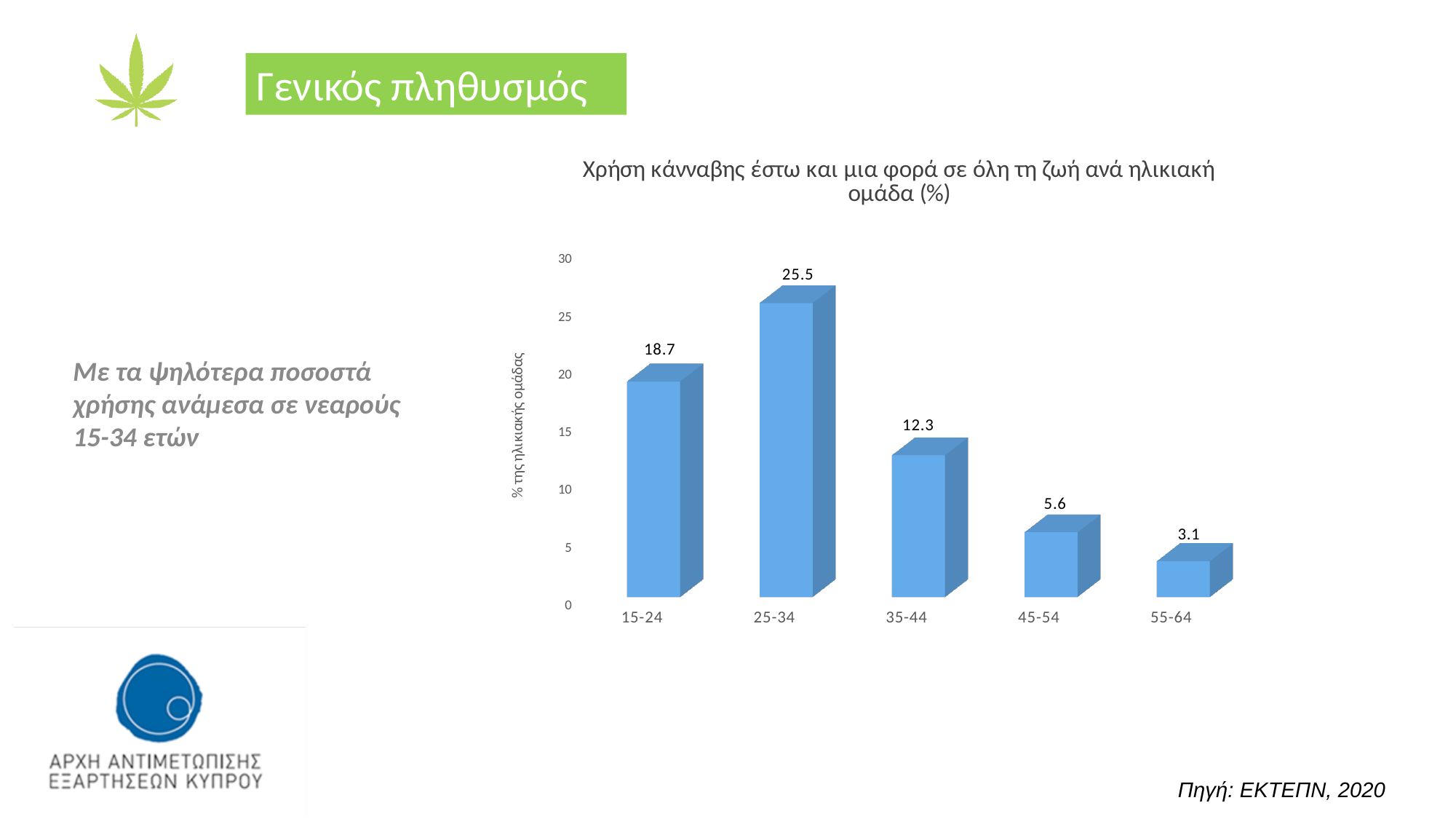
What kind of chart is shown on the slide? bar chart Which is larger, the value for 15-24 or the value for 35-44? 15-24 What is the label of the vertical axis? % της ηλικιακής ομάδας What is the difference between the values for 45-54 and 55-64? 2.5 What is the value for the 25-34 age group? 25.5 How many age groups are shown on the chart? 5 Which age group has the lowest value? 55-64 Is the value for 45-54 greater or less than 10? less What is the value for the 35-44 age group? 12.3 What is the value for the 55-64 age group? 3.1 Which age group has the highest value? 25-34 What is the difference between the values for 25-34 and 15-24? 6.8